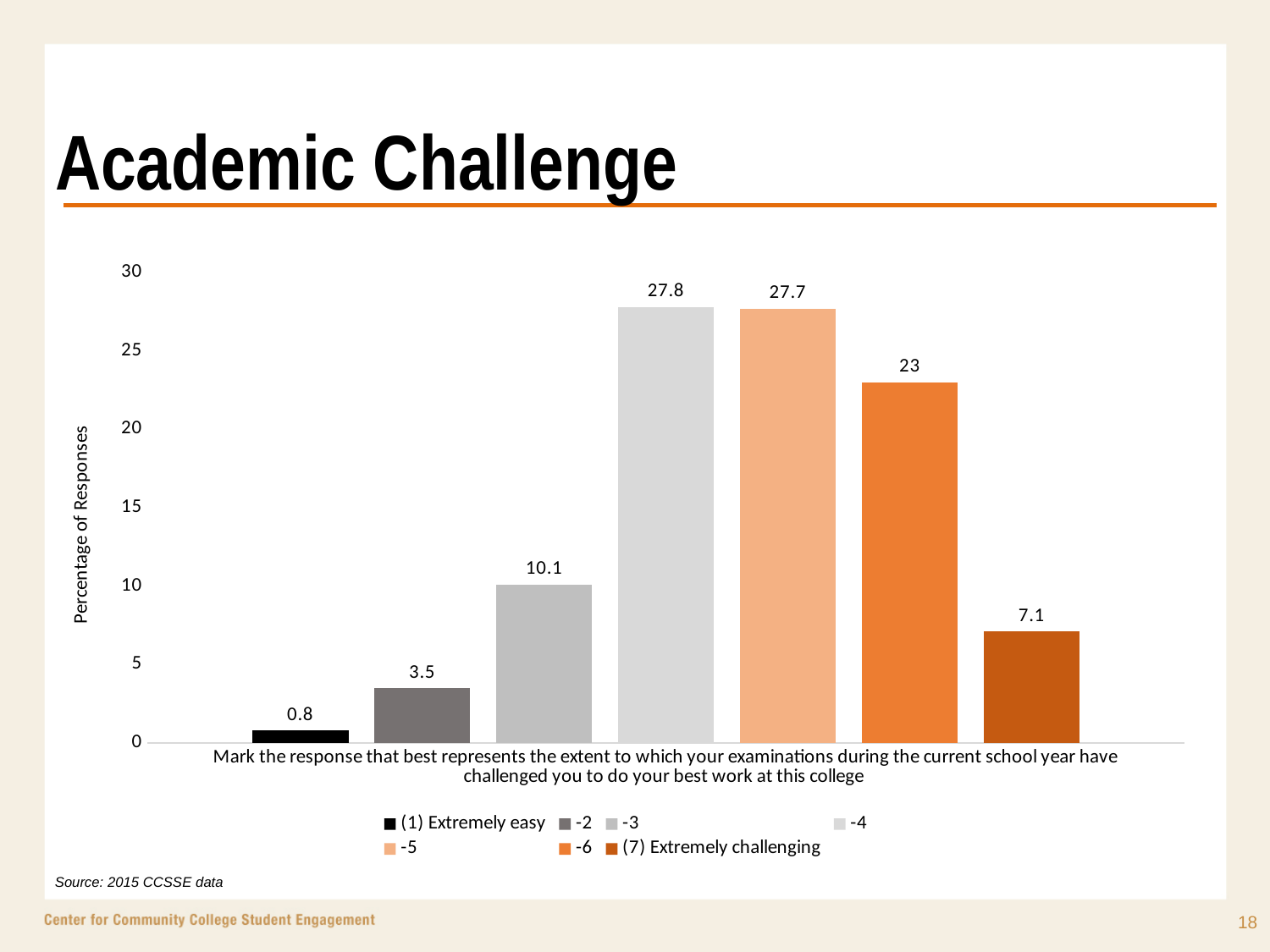
What kind of chart is shown on the slide? Bar chart Which response option has the highest percentage of responses? -4 What is the value of the bar for response "-6"? 23 What is the label of the vertical axis? Percentage of Responses Which is larger, the value for "-3" or the value for "-6"? -6 What is the value of the bar for response "-4"? 27.8 What percentage of responses is shown for "(1) Extremely easy"? 0.8 What percentage of responses is shown for "(7) Extremely challenging"? 7.1 How many series does the legend list? 7 What is the difference between the values for "-6" and "(7) Extremely challenging"? 15.9 What is the difference between the values for "-3" and "-2"? 6.6 Which response option has the lowest percentage of responses? (1) Extremely easy